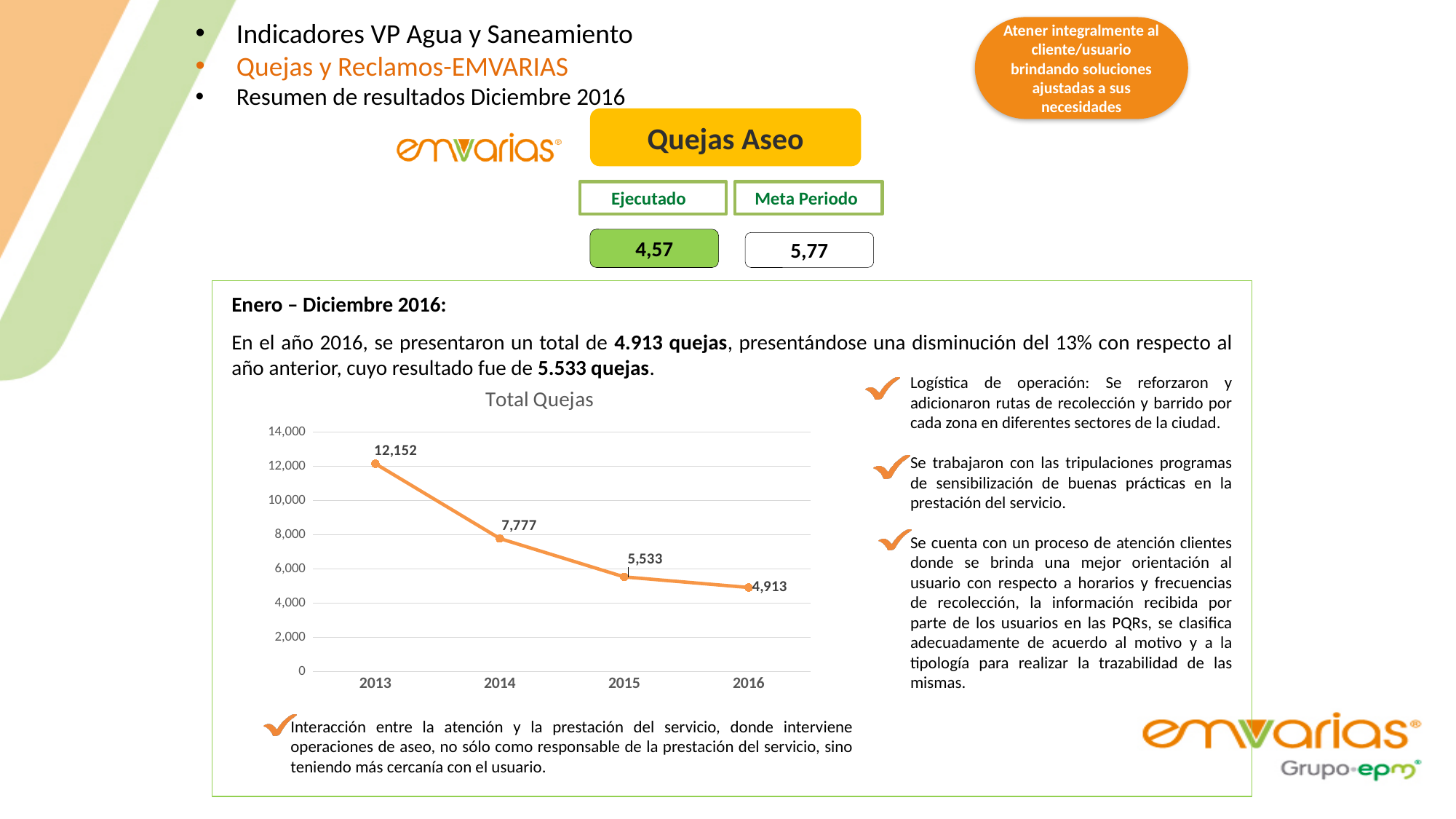
Do the values in the Total Quejas chart rise or fall from 2013 to 2016? fall Which year has the highest value in the Total Quejas chart? 2013 What is the value for 2013 in the Total Quejas chart? 12,152 What is the value for 2016 in the Total Quejas chart? 4,913 What kind of chart is the Total Quejas chart? line chart Which is larger in the Total Quejas chart, the value for 2014 or the value for 2015? 2014 What is the difference between the 2013 and 2014 values in the Total Quejas chart? 4,375 Which year has the lowest value in the Total Quejas chart? 2016 What is the difference between the 2015 and 2016 values in the Total Quejas chart? 620 What is the value for 2014 in the Total Quejas chart? 7,777 How many years are plotted in the Total Quejas chart? 4 What is the value for 2015 in the Total Quejas chart? 5,533